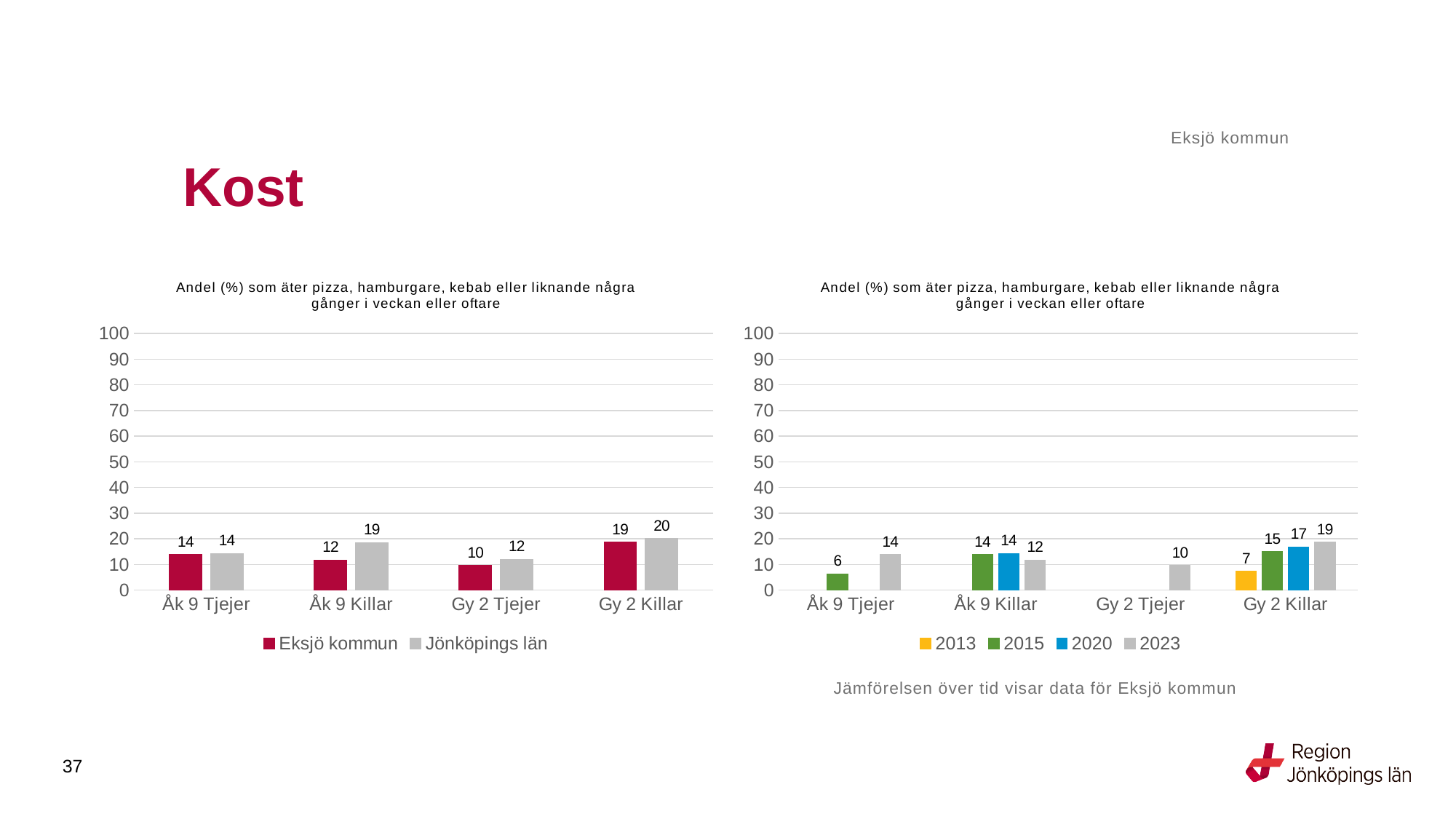
In the left chart, how many series does the legend list? 2 In the right chart, what is the value for 2015 for Åk 9 Tjejer? 6 In the right chart, how many series does the legend list? 4 In the right chart, what is the value for 2013 for Gy 2 Killar? 7 In the left chart, which is larger for Gy 2 Tjejer: Eksjö kommun or Jönköpings län? Jönköpings län In the left chart, what is the difference between Jönköpings län and Eksjö kommun for Åk 9 Killar? 7 In the right chart, do the values for Gy 2 Killar rise or fall from 2013 to 2023? rise In the left chart, what is the value for Jönköpings län for Åk 9 Killar? 19 In the left chart, what is the value for Eksjö kommun for Gy 2 Killar? 19 In the left chart, which category has the lowest value for Eksjö kommun? Gy 2 Tjejer What kind of chart is the left chart? bar chart In the right chart, what is the difference between 2023 and 2013 for Gy 2 Killar? 12